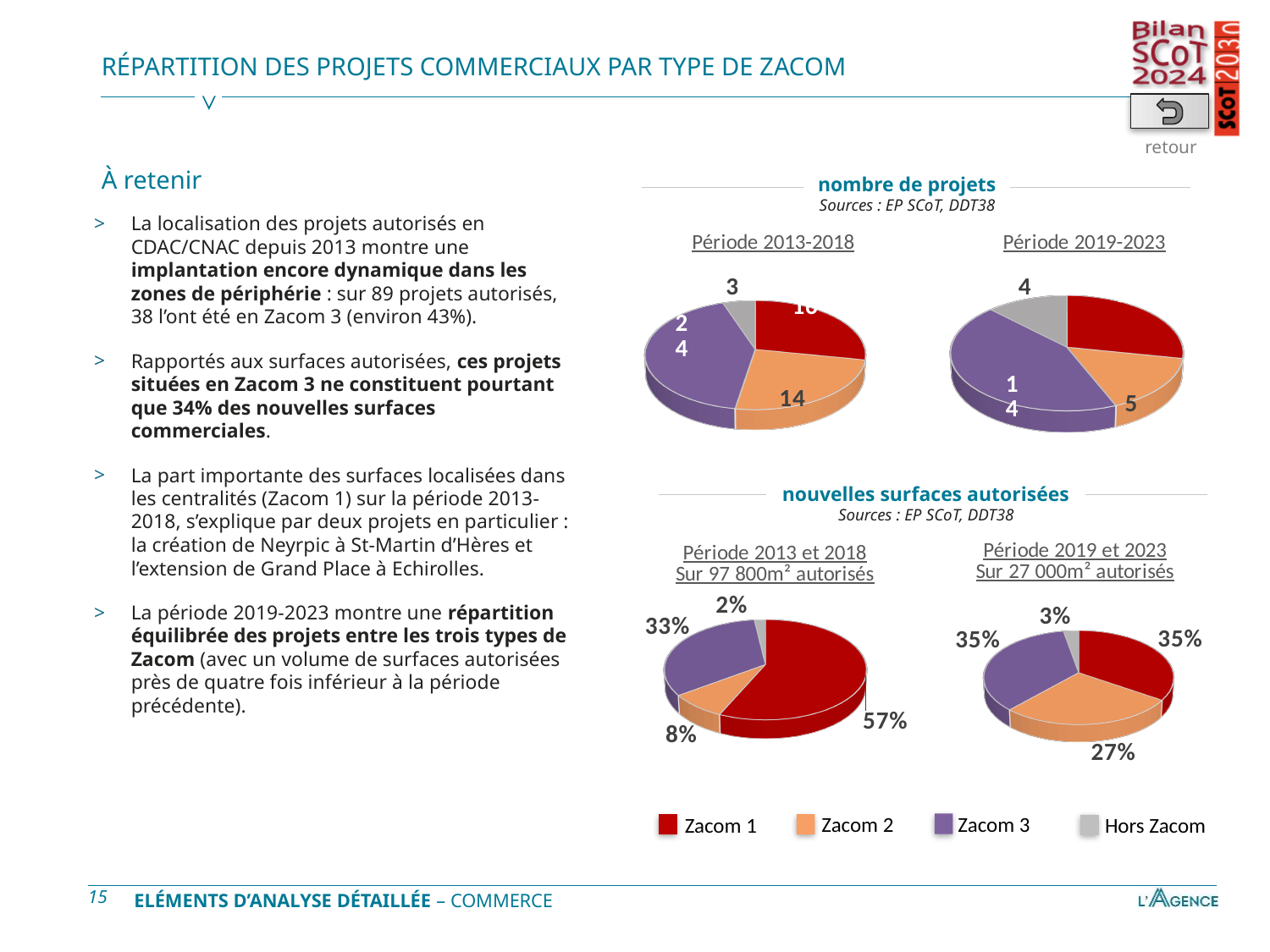
In the 'nombre de projets' chart for Période 2013-2018, which has more projects: Zacom 2 or Hors Zacom? Zacom 2 In the 'nouvelles surfaces autorisées' chart for Période 2019 et 2023, which category has the smallest share? Hors Zacom In the 'nouvelles surfaces autorisées' chart for Période 2013 et 2018, which category has the largest share? Zacom 1 In the 'nombre de projets' chart for Période 2019-2023, how many projects are in Zacom 2? 5 In the 'nouvelles surfaces autorisées' chart for Période 2019 et 2023, what share is Zacom 2? 27% In the 'nombre de projets' chart for Période 2019-2023, how many projects are Hors Zacom? 4 How many categories does the shared legend list for the pie charts? 4 In the 'nouvelles surfaces autorisées' chart for Période 2013 et 2018, what is the difference in percentage points between Zacom 1 and Zacom 3? 24 percentage points In the 'nouvelles surfaces autorisées' chart for Période 2013 et 2018, what share is Zacom 1? 57% What kind of chart is used to show the 'nombre de projets' for Période 2013-2018? Pie chart In the 'nombre de projets' chart for Période 2013-2018, how many projects are in Zacom 2? 14 In the 'nombre de projets' chart for Période 2013-2018, how many projects are Hors Zacom? 3